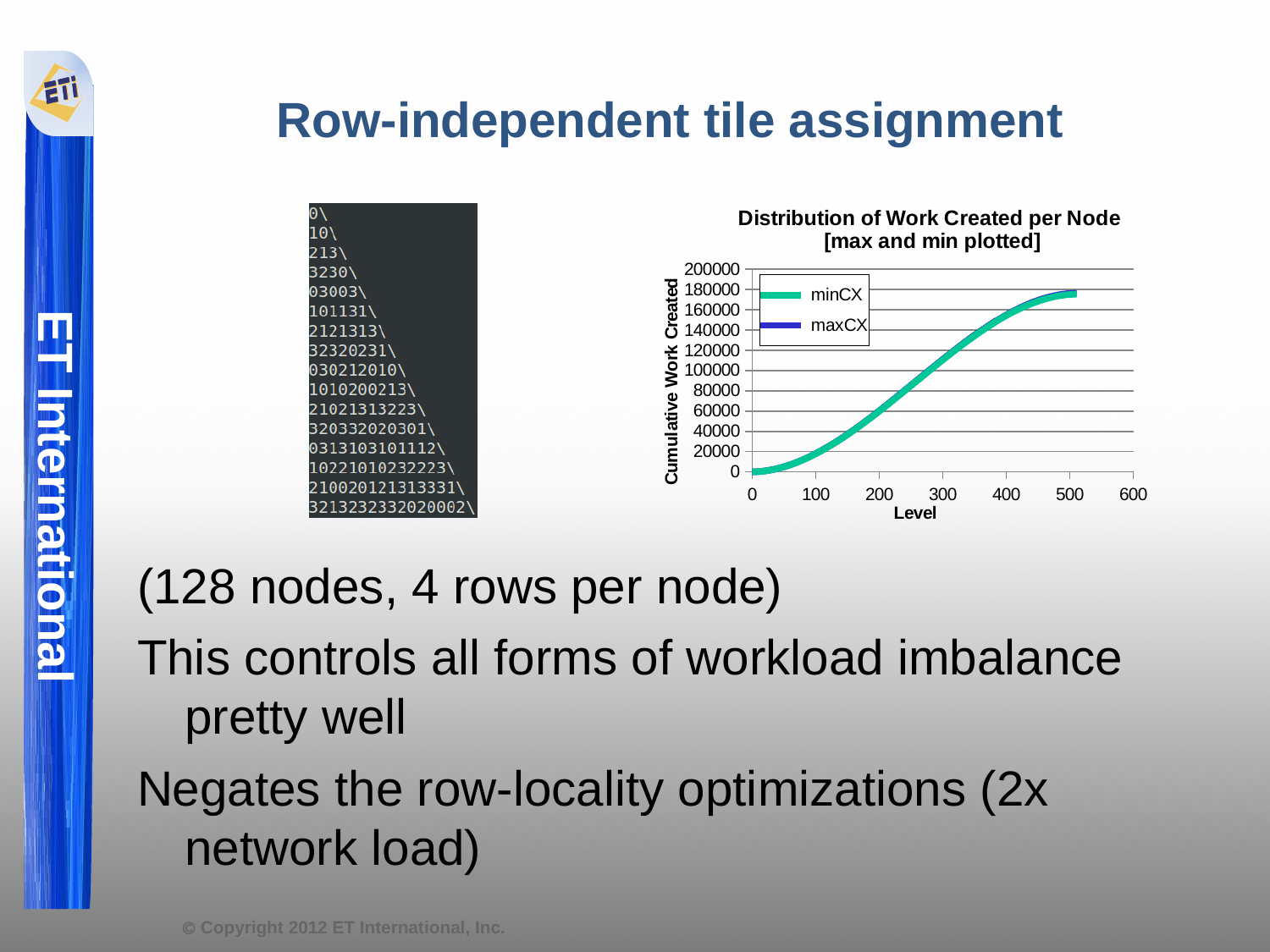
Is the value of the minCX series at Level 500 greater or less than 140000? greater What are the two series named in the chart legend? minCX and maxCX What is the highest tick value shown on the x axis of the chart? 600 Do the plotted values rise or fall as Level increases along the x axis? rise Is the value of the maxCX series at Level 100 greater or less than 40000? less How many series does the legend of the chart list? 2 What is the title of the chart? Distribution of Work Created per Node [max and min plotted] What kind of chart is shown on the slide? line chart Is the value of the maxCX series at Level 400 greater or less than 120000? greater What is the highest tick value shown on the y axis of the chart? 200000